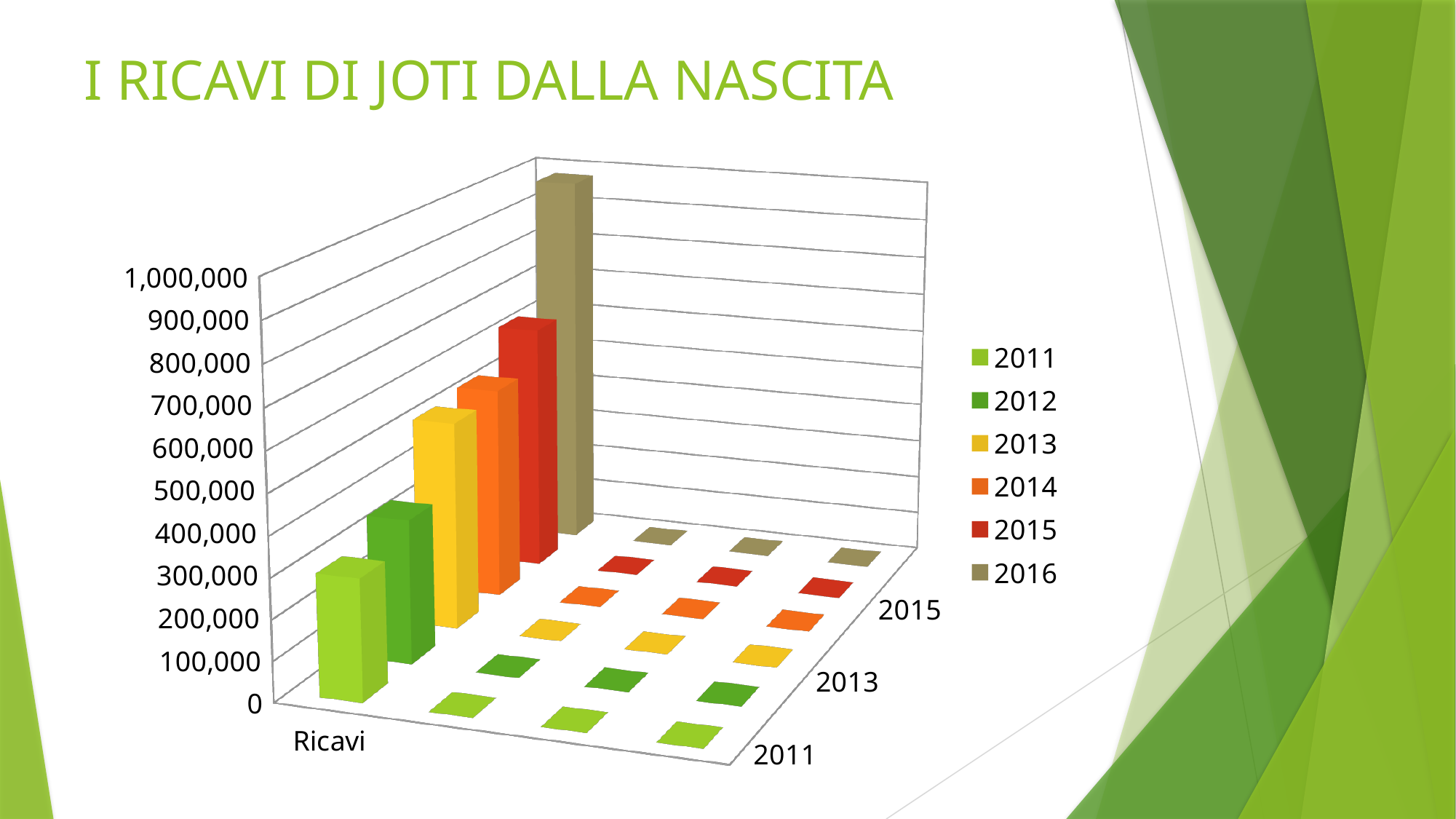
How many series does the legend list? 6 What kind of chart is shown on the slide? bar chart Which years are listed in the legend? 2011, 2012, 2013, 2014, 2015, 2016 Is the Ricavi value for 2016 greater or less than 500,000? greater What is the title of the slide containing the chart? I RICAVI DI JOTI DALLA NASCITA Do the Ricavi values rise or fall from 2011 to 2016? rise Which year has the lowest Ricavi bar? 2011 How many bars are plotted for the Ricavi category? 6 Which is larger, the Ricavi bar for 2013 or for 2011? 2013 Which year has the highest Ricavi bar? 2016 Is the Ricavi value for 2011 greater or less than 500,000? less Which is larger, the Ricavi bar for 2015 or for 2012? 2015